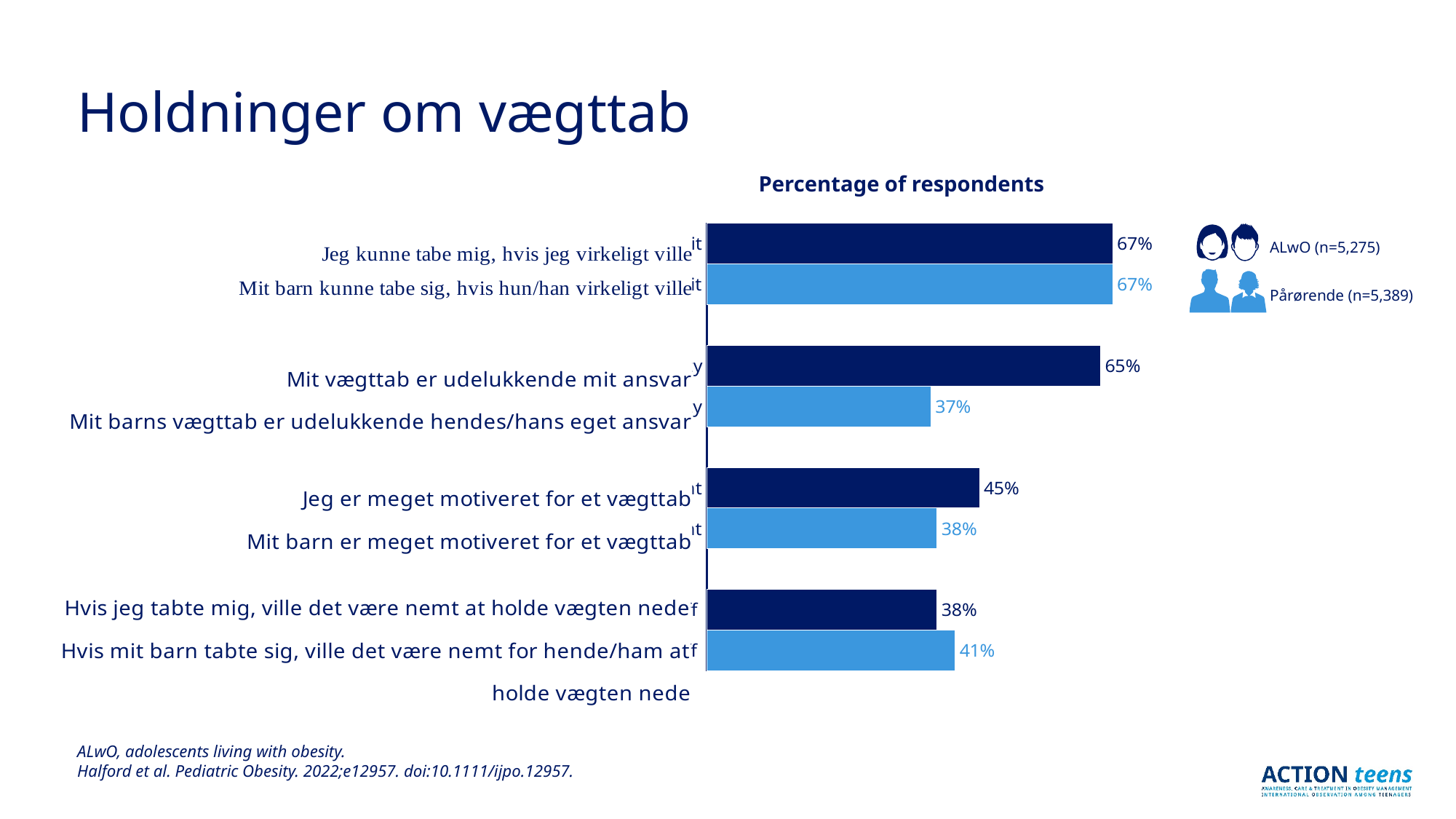
What is the value for ALwO respondents for "Jeg er meget motiveret for et vægttab"? 45% Which statement has the lowest value among the Pårørende bars? Mit barns vægttab er udelukkende hendes/hans eget ansvar What percentage of ALwO respondents agreed with "Jeg kunne tabe mig, hvis jeg virkeligt ville"? 67% What is the sample size (n) for the Pårørende group shown in the legend? 5,389 Which is larger: the ALwO value for "Hvis jeg tabte mig, ville det være nemt at holde vægten nede" or the Pårørende value for "Hvis mit barn tabte sig, ville det være nemt for hende/ham at holde vægten nede"? Pårørende (41%) What percentage of Pårørende respondents agreed with "Mit barns vægttab er udelukkende hendes/hans eget ansvar"? 37% What is the difference between the ALwO value for "Mit vægttab er udelukkende mit ansvar" and the Pårørende value for "Mit barns vægttab er udelukkende hendes/hans eget ansvar"? 28 percentage points What is the difference between the ALwO and Pårørende values for being very motivated for weight loss? 7 percentage points What is the value for Pårørende respondents for "Hvis mit barn tabte sig, ville det være nemt for hende/ham at holde vægten nede"? 41% What type of chart is shown on the slide? Bar chart How many groups of respondents does the legend list? 2 Which statement has the lowest value among the ALwO bars? Hvis jeg tabte mig, ville det være nemt at holde vægten nede